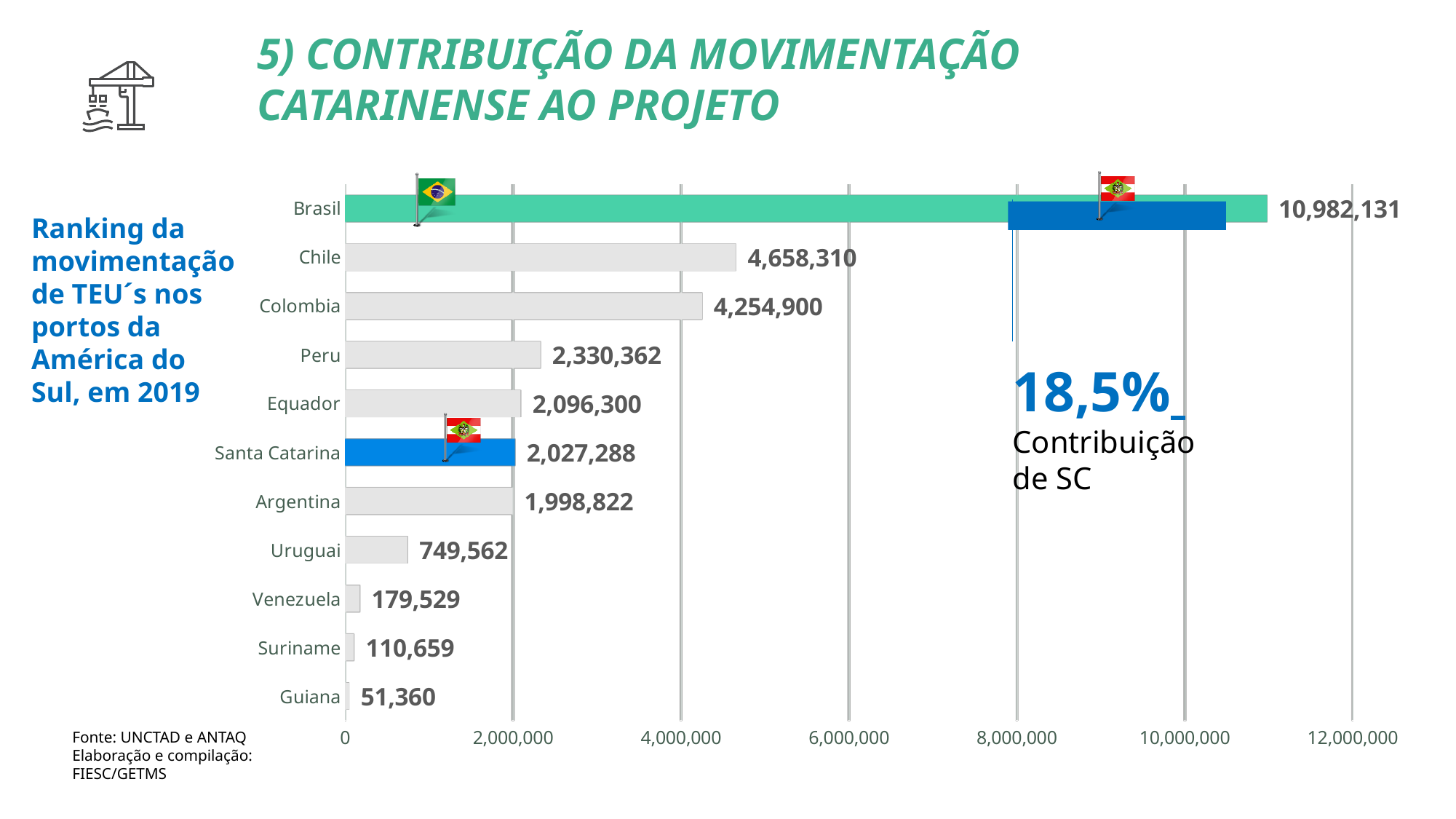
Is the value for Chile greater or less than 4,000,000? greater What is the value for Uruguai? 749,562 What is the difference between the values for Chile and Colombia? 403,410 What kind of chart is shown on the slide? bar chart What is the value for Brasil? 10,982,131 Which category has the lowest value? Guiana What percentage is given as the contribution of SC (Santa Catarina)? 18,5% How many categories are shown in the chart? 11 Which is larger, the value for Peru or the value for Equador? Peru Which category has the highest value? Brasil What is the difference between the values for Santa Catarina and Argentina? 28,466 What is the value for Santa Catarina? 2,027,288